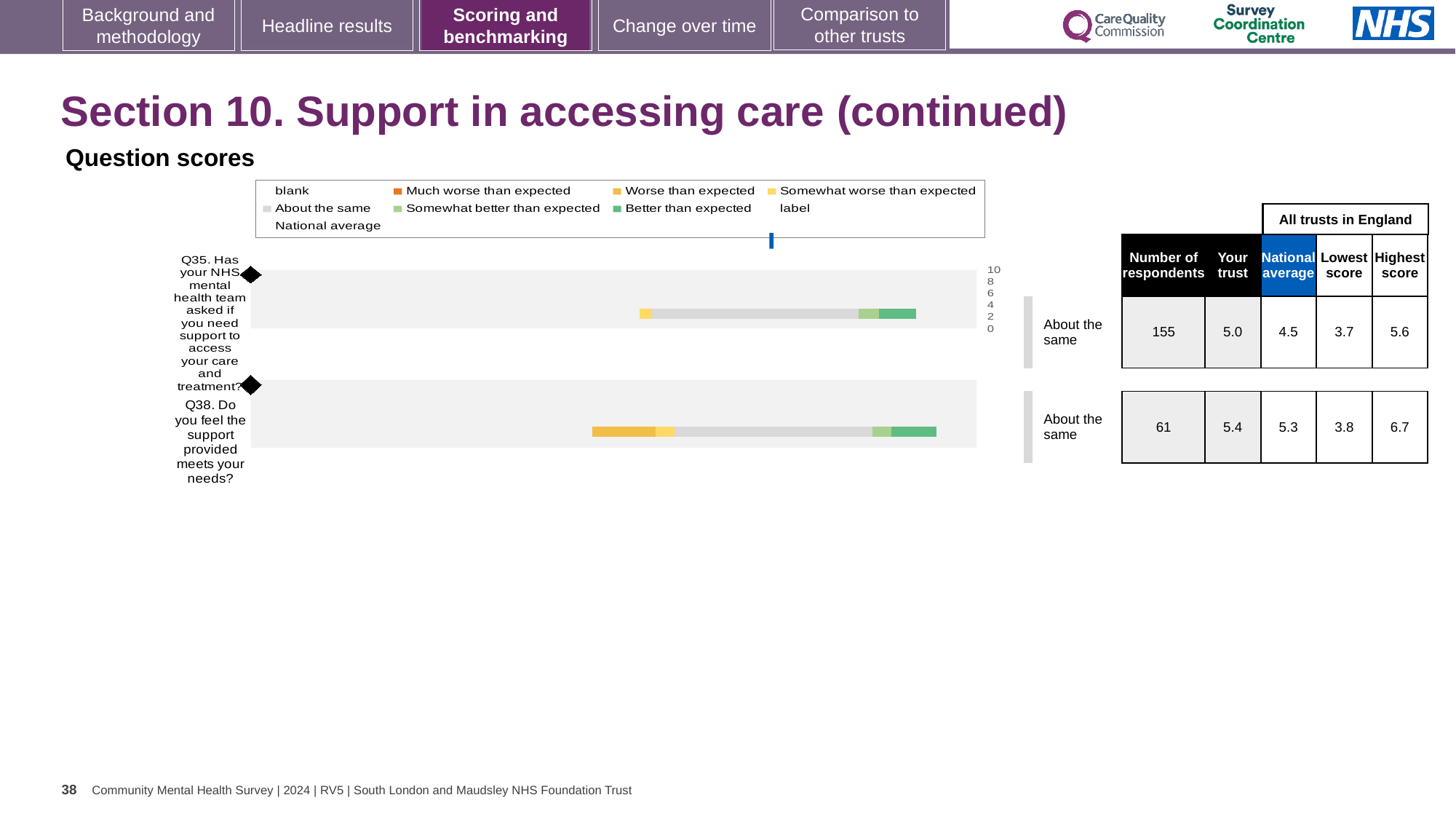
What kind of chart is shown under 'Question scores'? bar chart What benchmark category is shown for Q35? About the same What is the 'Your trust' score for Q35 (Has your NHS mental health team asked if you need support to access your care and treatment?)? 5.0 What is the lowest score among all trusts in England for Q35? 3.7 How many respondents answered Q38 (Do you feel the support provided meets your needs?)? 61 Which question has the higher 'Your trust' score, Q35 or Q38? Q38 By how much does the trust's score for Q35 exceed the national average? 0.5 How many questions (bars) are plotted in the chart? 2 What is the national average score for Q35? 4.5 How many respondents answered Q35? 155 What is the highest score among all trusts in England for Q38? 6.7 What is the difference between the highest score and the lowest score across all trusts in England for Q38? 2.9